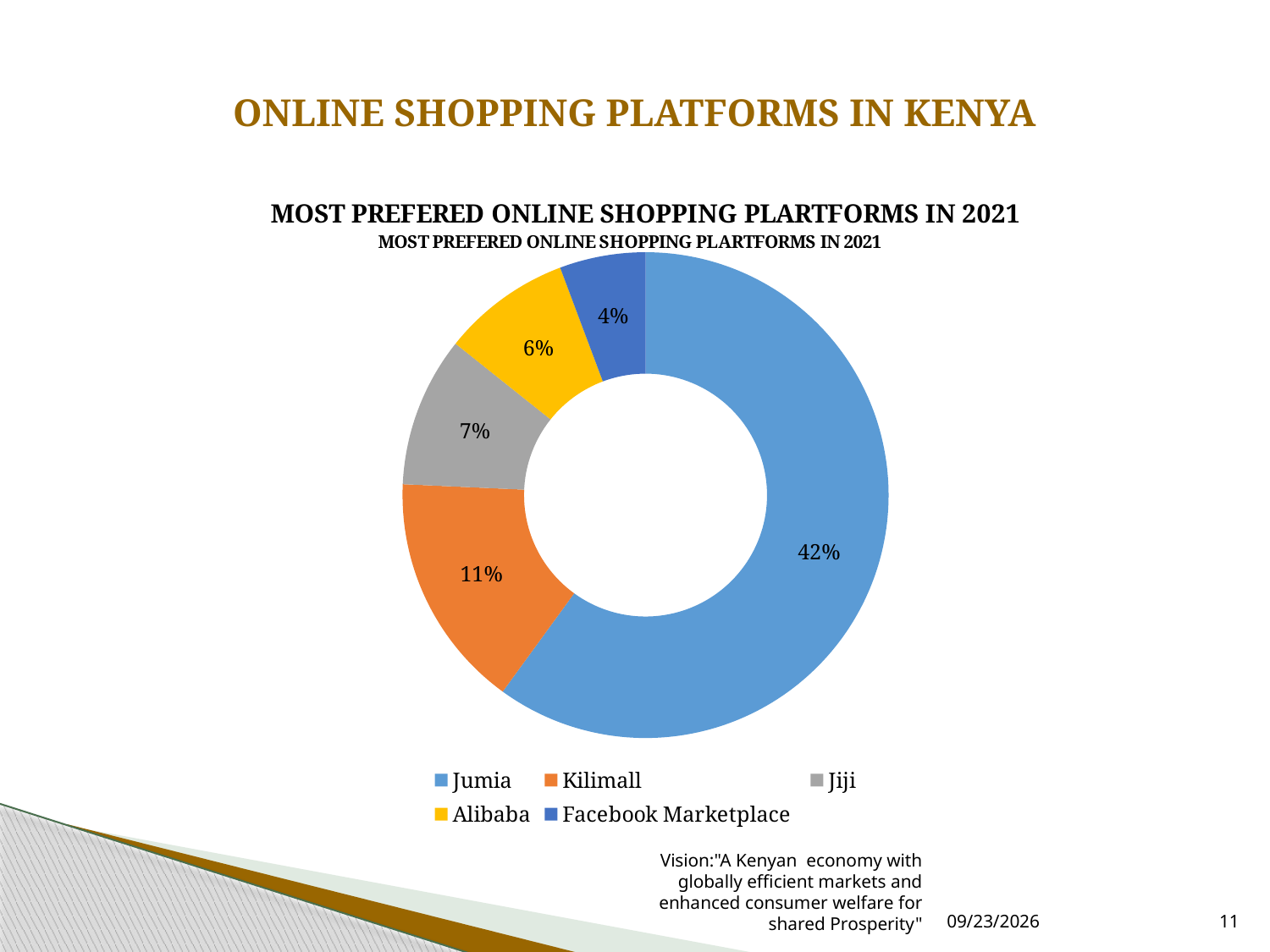
What percentage is shown for Jumia? 42% Which platform has the smallest share in the chart? Facebook Marketplace What percentage is shown for Facebook Marketplace? 4% What percentage is shown for Kilimall? 11% Which platform has the largest share in the chart? Jumia What percentage is shown for Jiji? 7% Which has a larger share, Jiji or Alibaba? Jiji How many platforms are shown in the chart? 5 What percentage is shown for Alibaba? 6% What is the difference in percentage points between Jumia and Kilimall? 31 What is the title of the chart? MOST PREFERED ONLINE SHOPPING PLARTFORMS IN 2021 What type of chart is shown on the slide? Doughnut chart